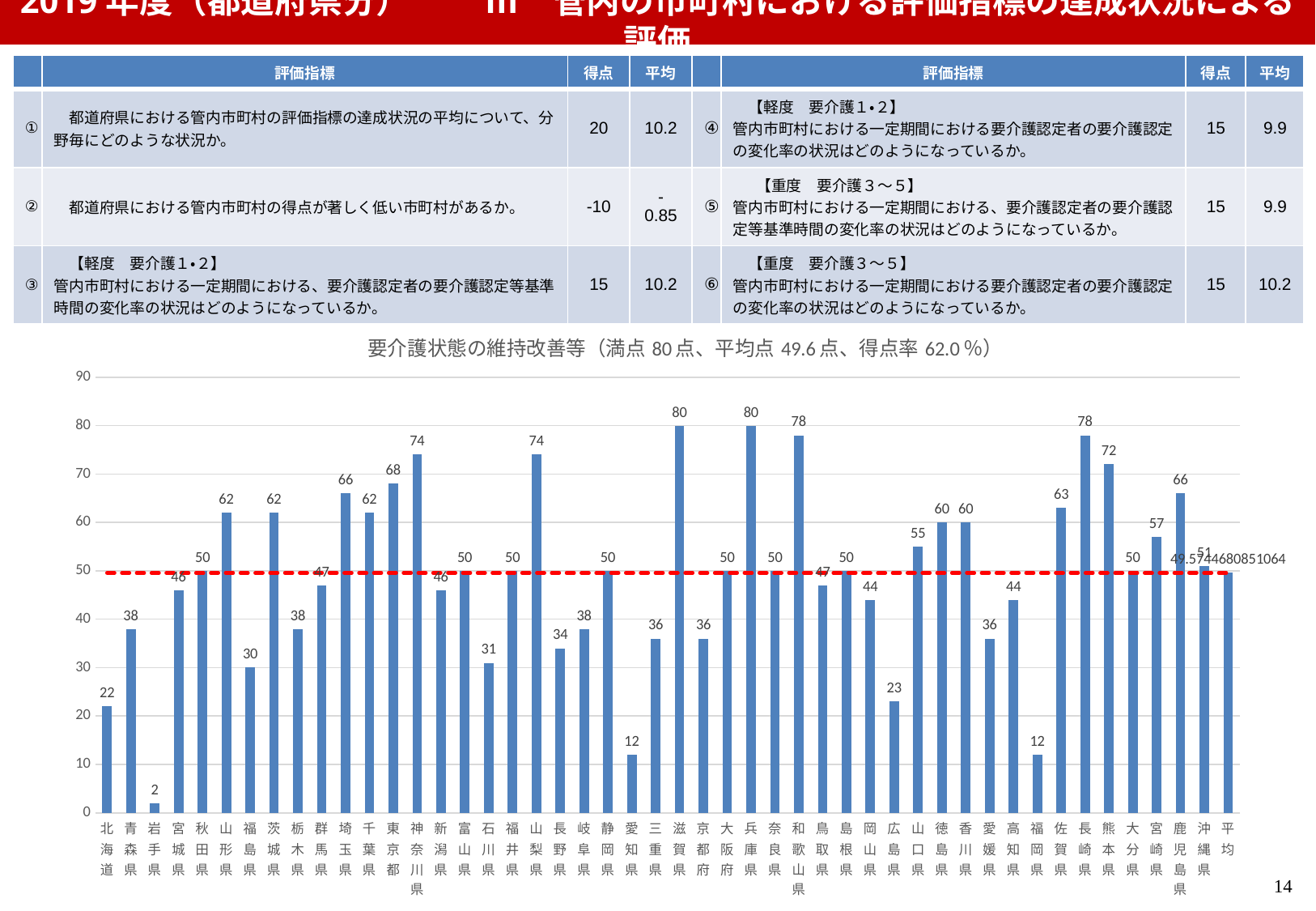
Is the value for 福島県 greater or less than 40? less According to the chart title, what is the full score (満点)? 80点 What is the difference between the values for 兵庫県 and 福岡県? 68 What is the value for 愛知県 in the chart? 12 What is the value for 北海道 in the chart? 22 Which has a higher value, 滋賀県 or 和歌山県? 滋賀県 What is the value for 広島県 in the chart? 23 What is the difference between the values for 神奈川県 and 東京都? 6 Which prefecture has the lowest value in the chart? 岩手県 What is the value for 長崎県 in the chart? 78 Which has a higher value, 熊本県 or 宮崎県? 熊本県 What kind of chart is shown on the slide? bar chart